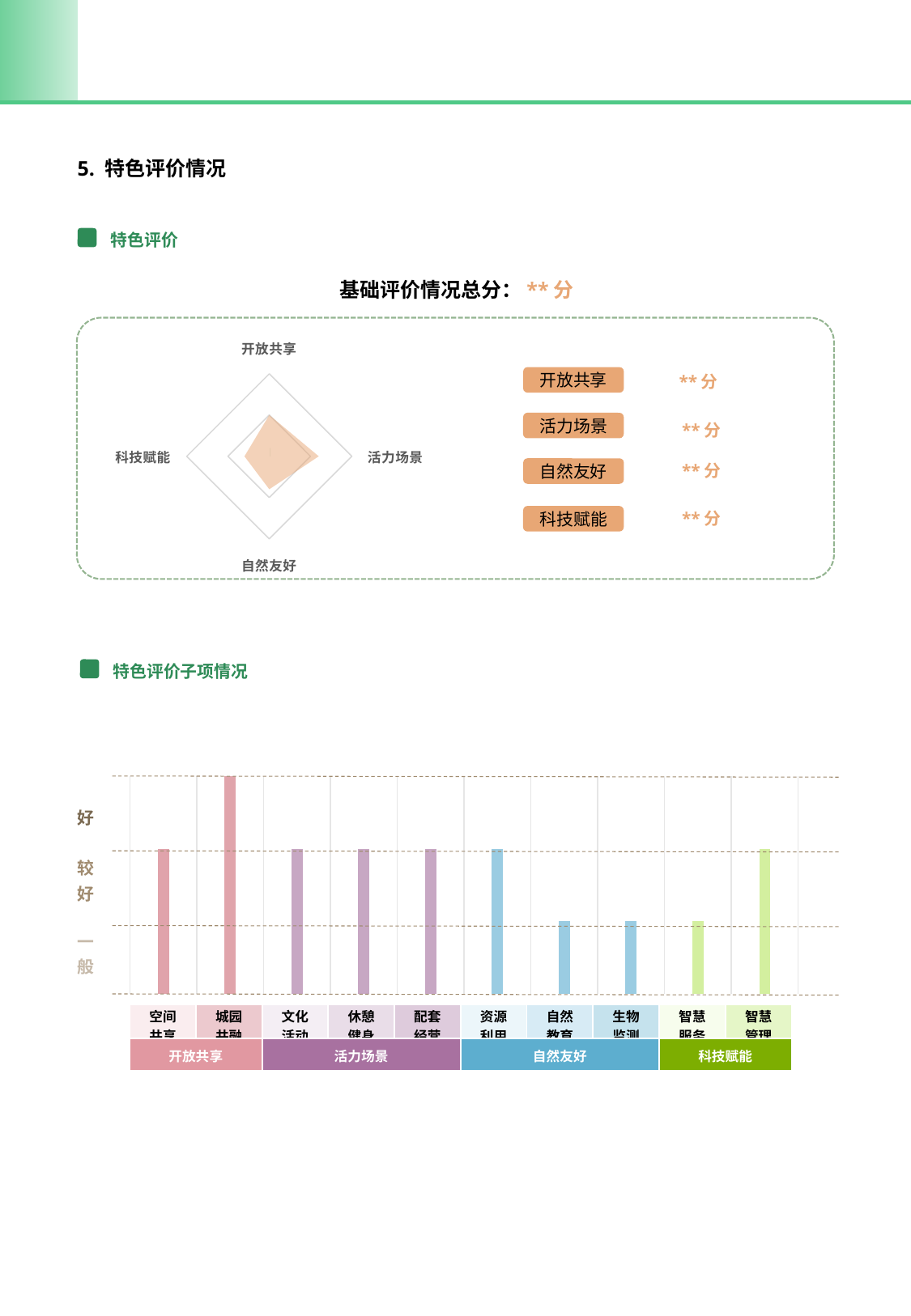
In the 特色评价子项情况 bar chart, how many category groups are shown along the bottom (开放共享, 活力场景, etc.)? 4 What kind of chart is shown inside the dashed box in the 特色评价 section? radar chart In the 特色评价子项情况 bar chart, which bar is the highest? 城园共融 In the 特色评价子项情况 bar chart, which rating level does the 自然教育 bar reach? 一般 In the 特色评价子项情况 bar chart, what are the three rating labels shown on the vertical axis, from top to bottom? 好, 较好, 一般 What kind of chart is shown in the 特色评价子项情况 section at the bottom of the slide? bar chart In the 特色评价子项情况 bar chart, which rating level does the 空间共享 bar reach? 较好 How many axes does the radar chart in the 特色评价 section have? 4 In the 特色评价子项情况 bar chart, which rating level does the 智慧管理 bar reach? 较好 In the 特色评价子项情况 bar chart, how many bars are plotted? 10 In the 特色评价子项情况 bar chart, which is taller: the 智慧服务 bar or the 智慧管理 bar? 智慧管理